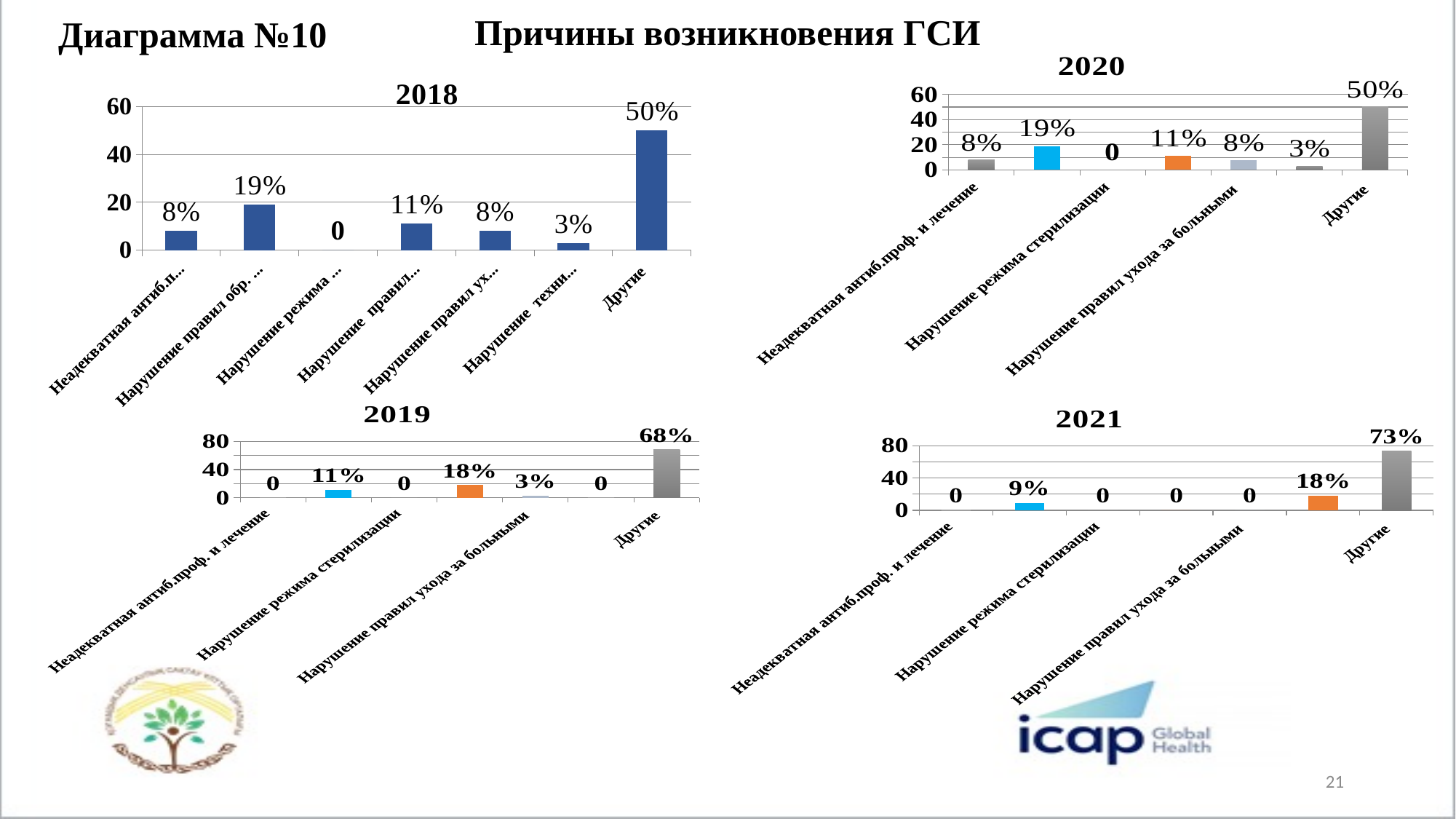
What is the title of the 2021 chart? 2021 What kind of chart is the 2018 chart? bar chart In the 2018 chart, what is the value for Другие? 50% In the 2021 chart, is the value for Другие greater or less than 40? greater In the 2021 chart, which category has the highest value? Другие In the 2020 chart, what is the difference between Другие and Нарушение режима стерилизации? 50% In the 2020 chart, what is the value for Нарушение режима стерилизации? 0 In the 2019 chart, what is the value for Другие? 68% In the 2019 chart, what is the value for Нарушение правил ухода за больными? 3% In the 2021 chart, what is the value for Неадекватная антиб.проф. и лечение? 0 How many categories are shown in the 2020 chart? 7 In the 2019 chart, which is larger: Нарушение режима стерилизации or Нарушение правил ухода за больными? Нарушение правил ухода за больными